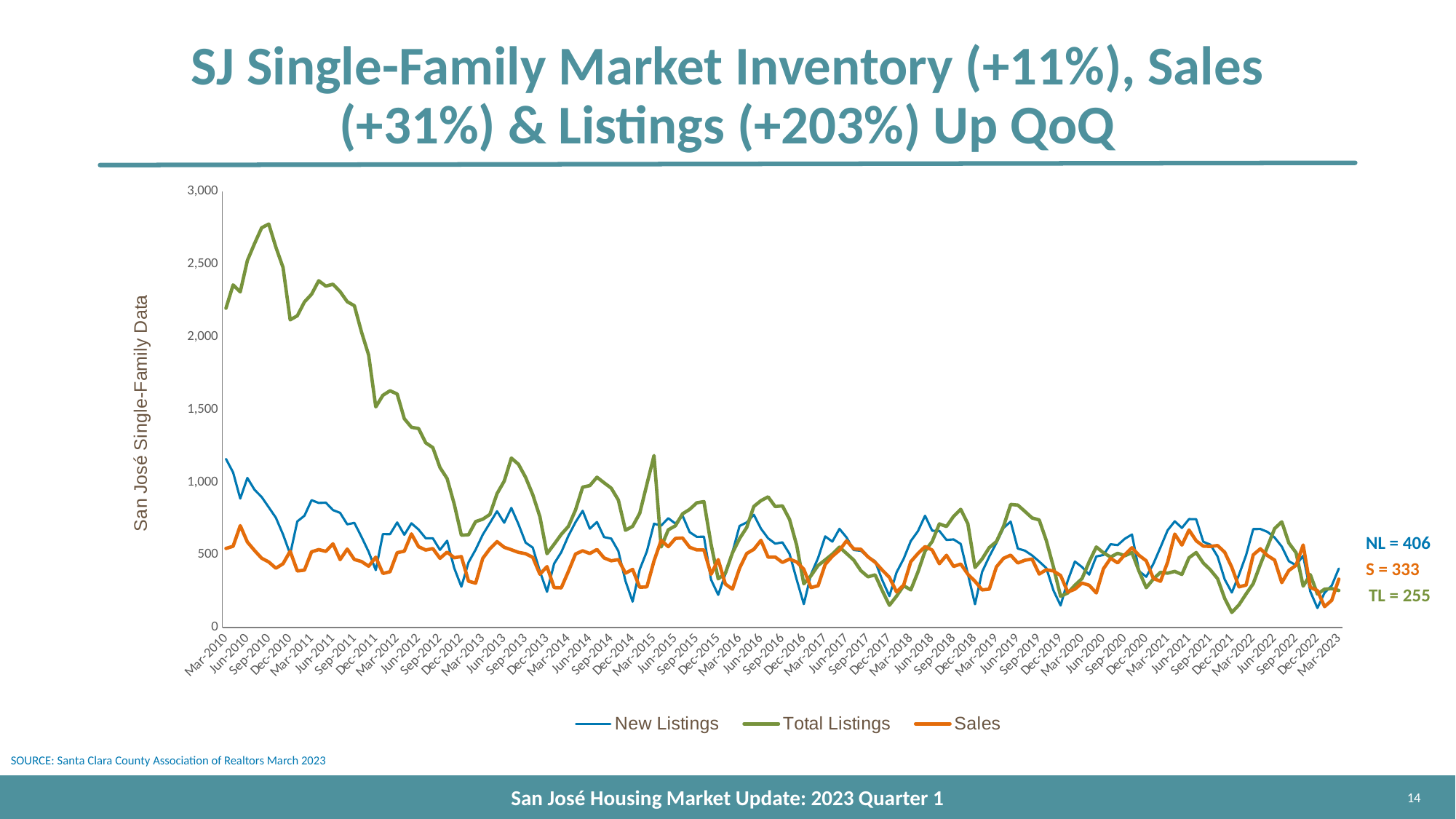
How many series does the legend list? 3 Does the Total Listings series rise or fall overall from Mar-2010 to Mar-2023? Fall At the end of the chart, which is larger: New Listings (NL) or Sales (S)? New Listings Is the Total Listings value in Sep-2010 greater or less than 2,500? greater What is the difference between the labelled New Listings value (NL) and the labelled Sales value (S)? 73 Which series reaches the highest value anywhere on the chart? Total Listings What is the Sales value labelled at the end of the chart (S)? 333 What is the Total Listings value labelled at the end of the chart (TL)? 255 What is the title of the vertical axis? San José Single-Family Data What is the difference between the labelled Sales value (S) and the labelled Total Listings value (TL)? 78 What is the New Listings value labelled at the end of the chart (NL)? 406 What type of chart is shown on the slide? Line chart